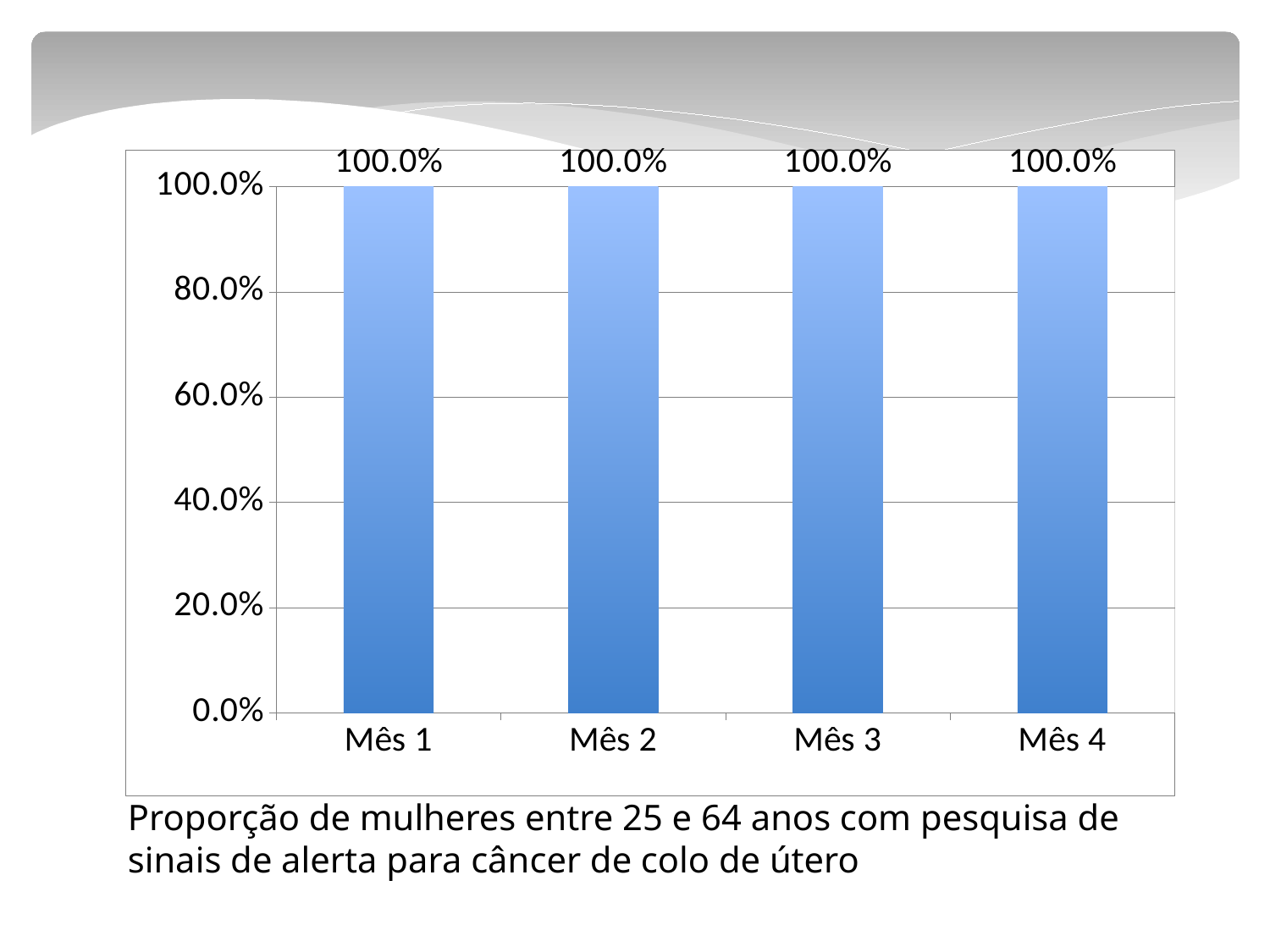
What is the value for Mês 1? 100.0% What is the value for Mês 4? 100.0% What is the difference between the values for Mês 1 and Mês 4? 0.0% Do the values rise, fall, or stay the same from Mês 1 to Mês 4? stay the same What is the highest value shown on the y axis? 100.0% What is the value for Mês 3? 100.0% Is the value for Mês 3 greater or less than 80.0%? greater What is the label of the first category on the x axis? Mês 1 What kind of chart is shown on the slide? bar chart How many categories are shown on the x axis? 4 What is the value for Mês 2? 100.0%